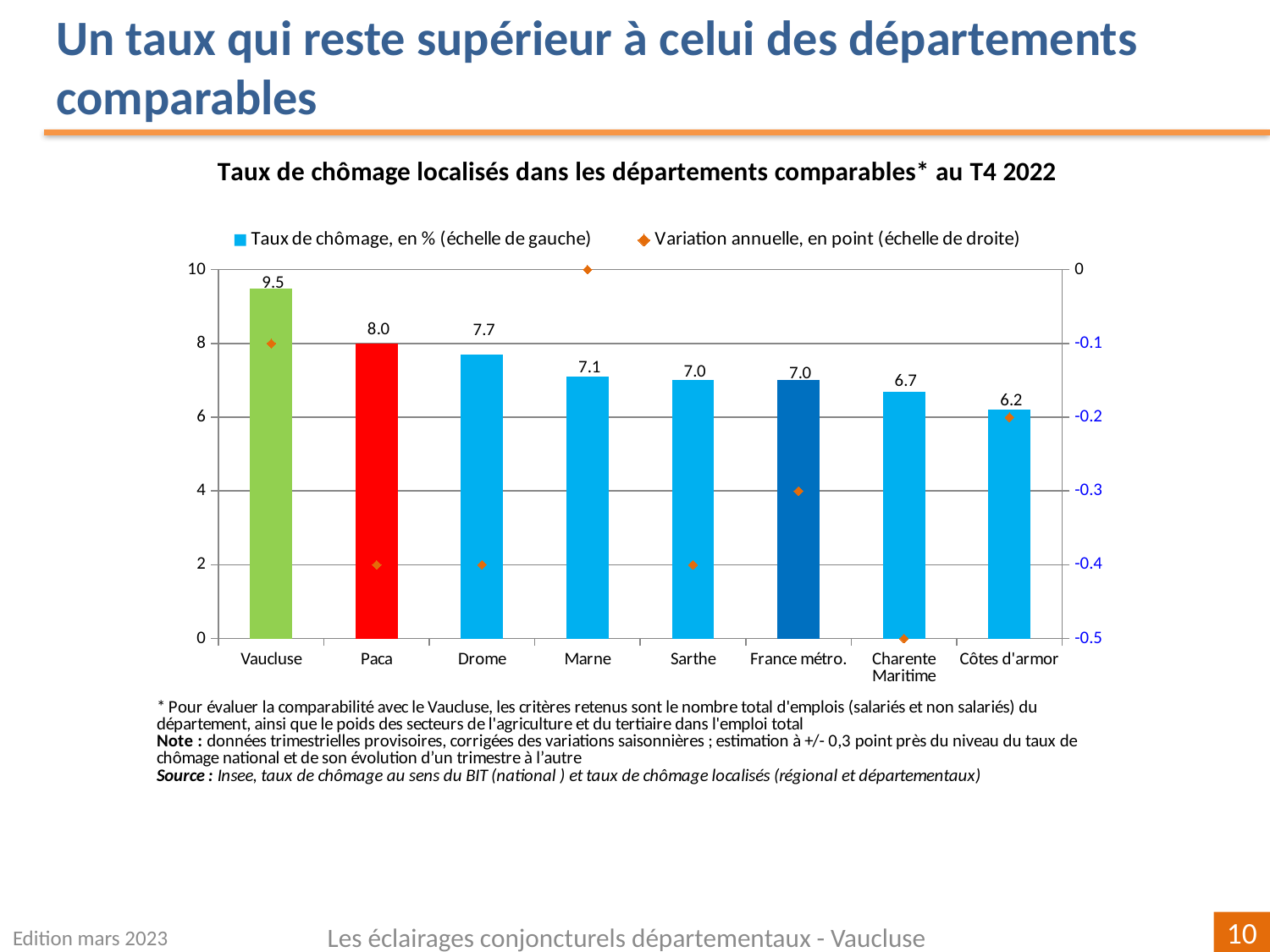
How many categories are shown on the x axis? 8 Which has a higher unemployment rate, Drome or Marne? Drome What is the annual variation (right axis) for Charente Maritime? -0.5 Which category has the highest unemployment rate bar? Vaucluse Which category has the lowest unemployment rate bar? Côtes d'armor What is the difference between the unemployment rates of Vaucluse and Paca? 1.5 What is the annual variation (Variation annuelle, right axis) for Marne? 0 What is the unemployment rate shown for Charente Maritime? 6.7 What is the title of the chart? Taux de chômage localisés dans les départements comparables* au T4 2022 What is the unemployment rate (Taux de chômage) shown for Vaucluse? 9.5 How many series does the legend list? 2 What kind of chart is used for the unemployment rate series? Bar chart